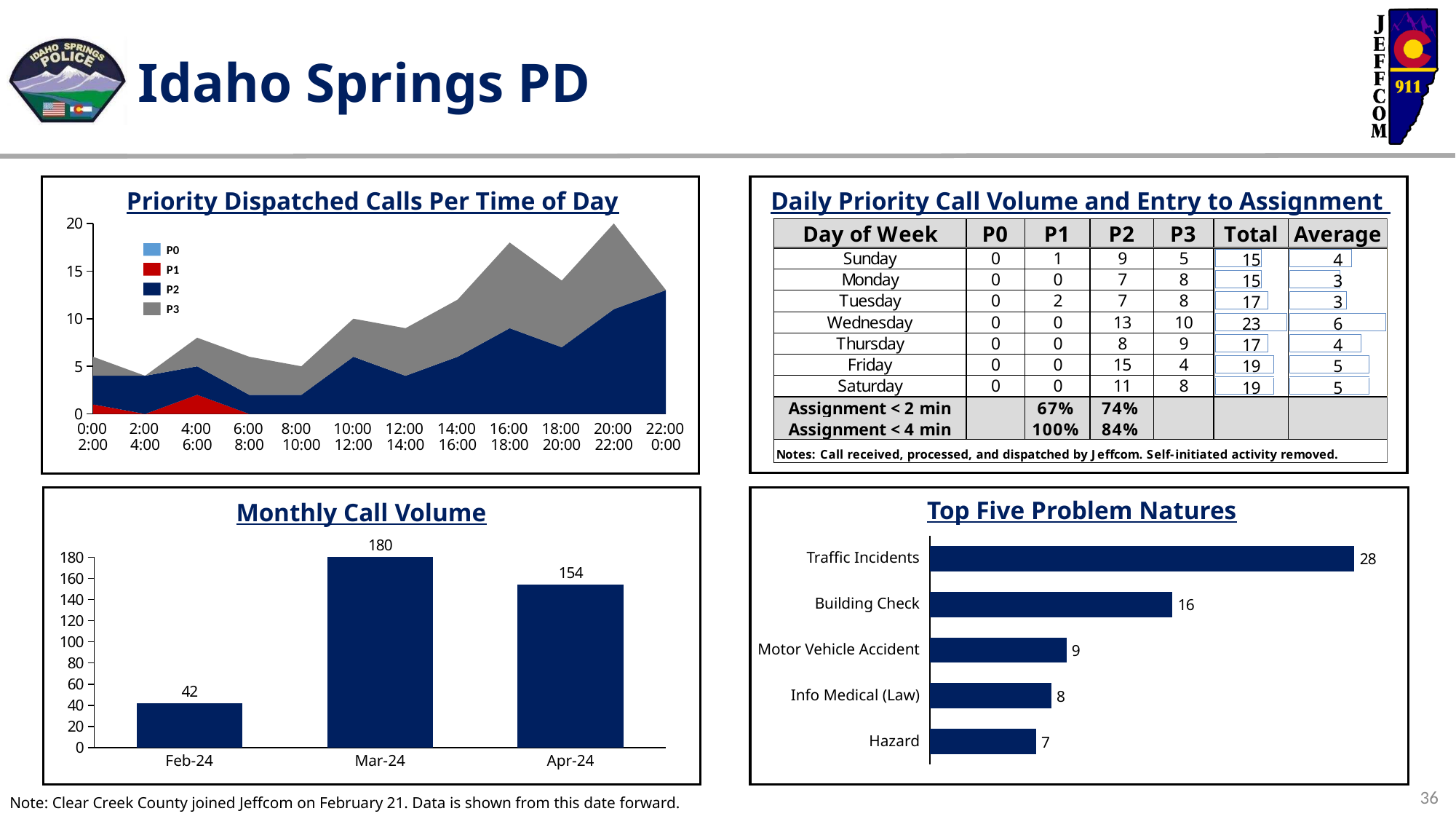
In the Top Five Problem Natures chart, which problem nature has the lowest value? Hazard In the Top Five Problem Natures chart, what is the difference between Traffic Incidents and Building Check? 12 In the Top Five Problem Natures chart, what is the value for Building Check? 16 In the Monthly Call Volume chart, how many months are shown? 3 In the Priority Dispatched Calls Per Time of Day chart, how many series does the legend list? 4 In the Monthly Call Volume chart, what is the value for Mar-24? 180 In the Top Five Problem Natures chart, which is larger, Motor Vehicle Accident or Info Medical (Law)? Motor Vehicle Accident In the Monthly Call Volume chart, what is the value for Feb-24? 42 What kind of chart is the Top Five Problem Natures chart? Bar chart In the Monthly Call Volume chart, which month has the highest call volume? Mar-24 In the Priority Dispatched Calls Per Time of Day chart, is the P2 value for the 22:00-0:00 period greater or less than 10? greater In the Monthly Call Volume chart, what is the difference between Mar-24 and Apr-24? 26